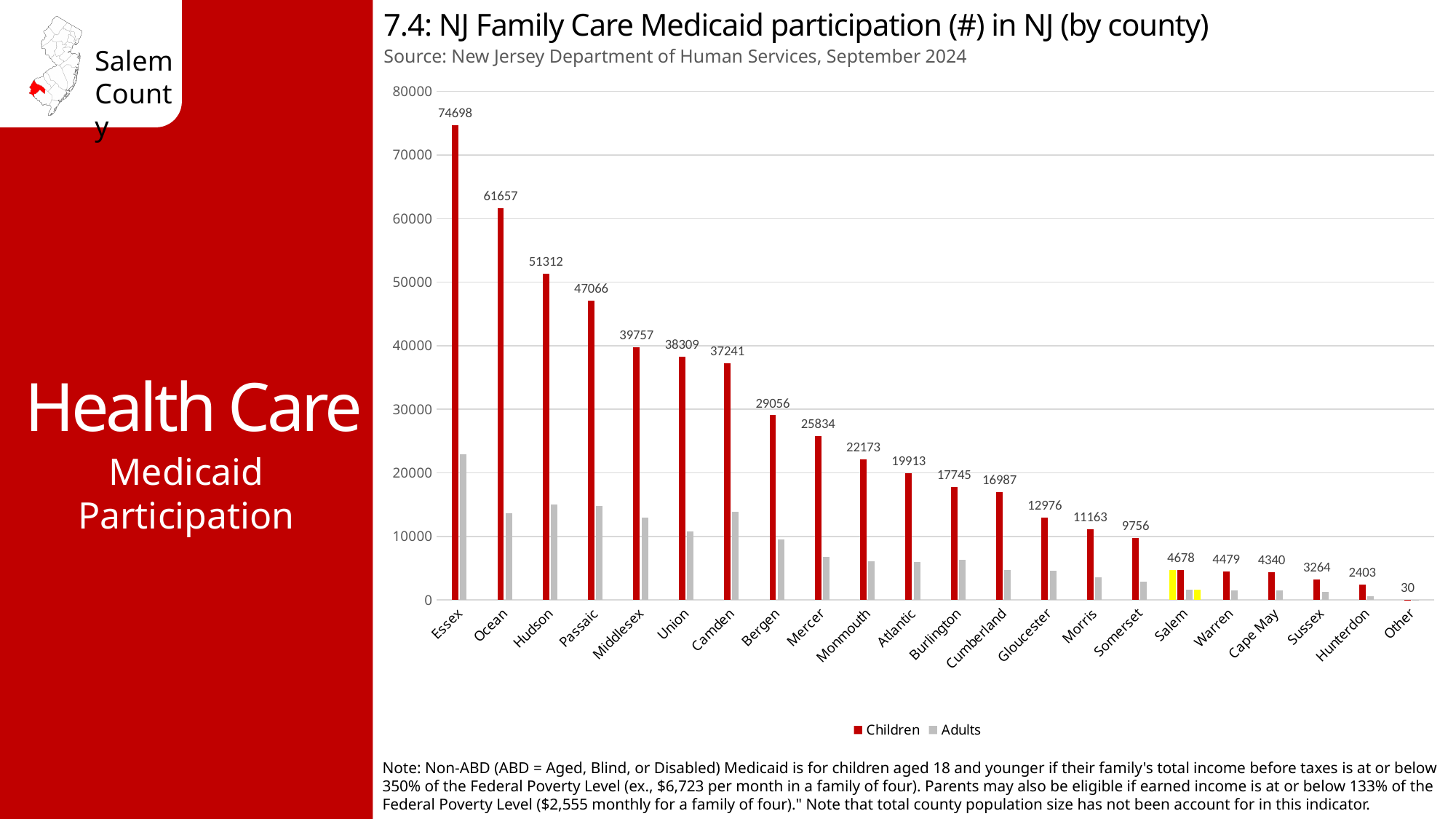
Is the Adults value for Salem greater or less than 10000? less How many series does the legend list? 2 Is the Adults value for Essex greater or less than 20000? greater What is the Children value for Cumberland? 16987 Which county has the highest Children value? Essex How many categories are shown on the x axis? 22 What kind of chart is shown? Bar chart What is the difference between the Children values for Essex and Ocean? 13041 What is the Children value for Essex? 74698 What is the Children value for Salem? 4678 Which category has the lowest Children value? Other Which has a larger Children value, Gloucester or Morris? Gloucester